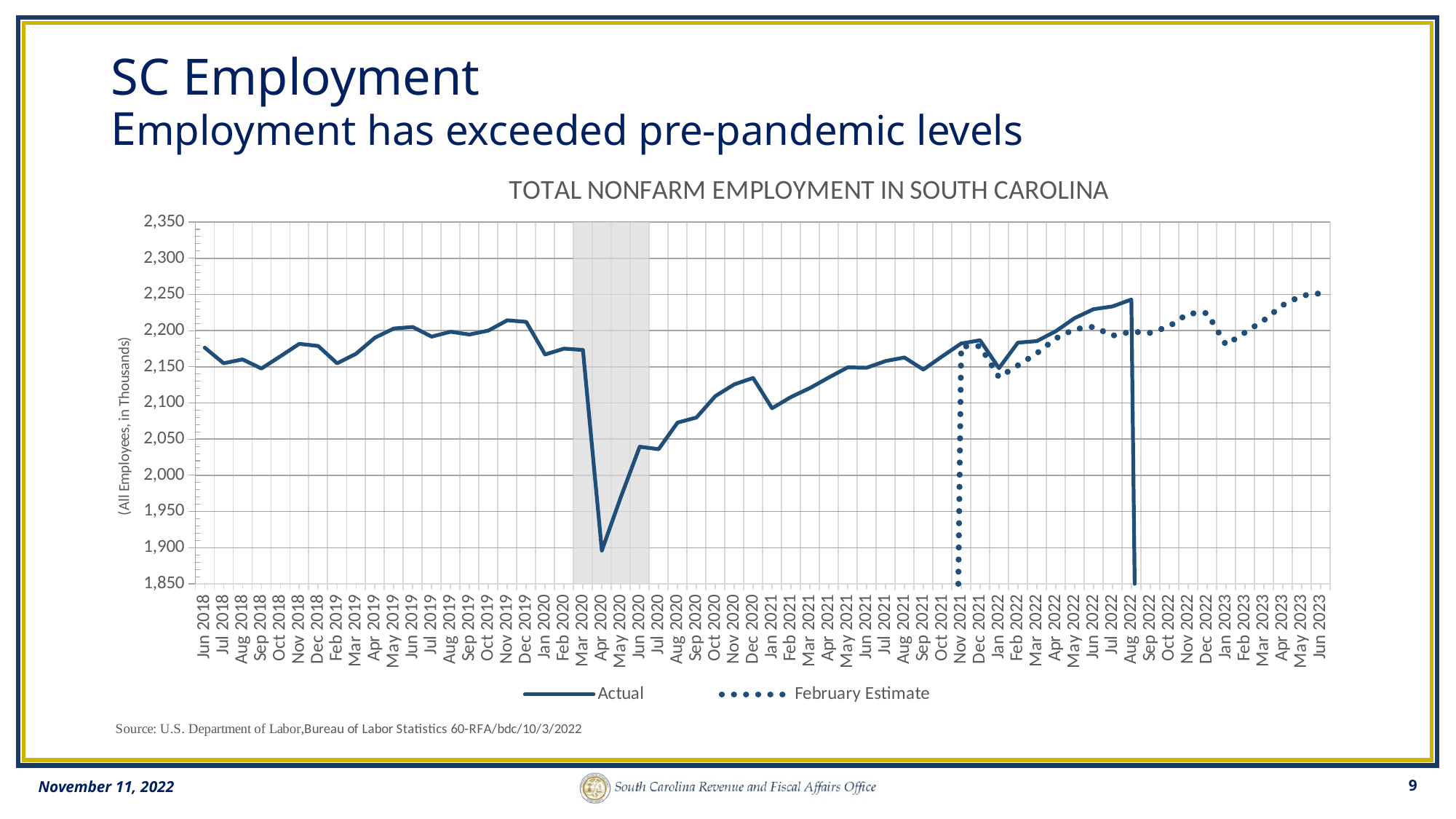
In which month does the Actual series reach its lowest value? Apr 2020 Is the Actual value for Jun 2020 greater or less than 2,100? less Is the February Estimate value for Jun 2023 greater or less than 2,200? greater Is the Actual value for Aug 2022 greater or less than 2,200? greater What kind of chart is shown on the slide? Line chart What is the title of the chart? TOTAL NONFARM EMPLOYMENT IN SOUTH CAROLINA In which month does the Actual series reach its highest value? Aug 2022 What are the two series named in the legend? Actual and February Estimate Which is larger, the Actual value for Aug 2022 or the Actual value for Nov 2019? Aug 2022 Does the Actual series generally rise or fall from Apr 2020 to Aug 2022? rise How many series does the legend list? 2